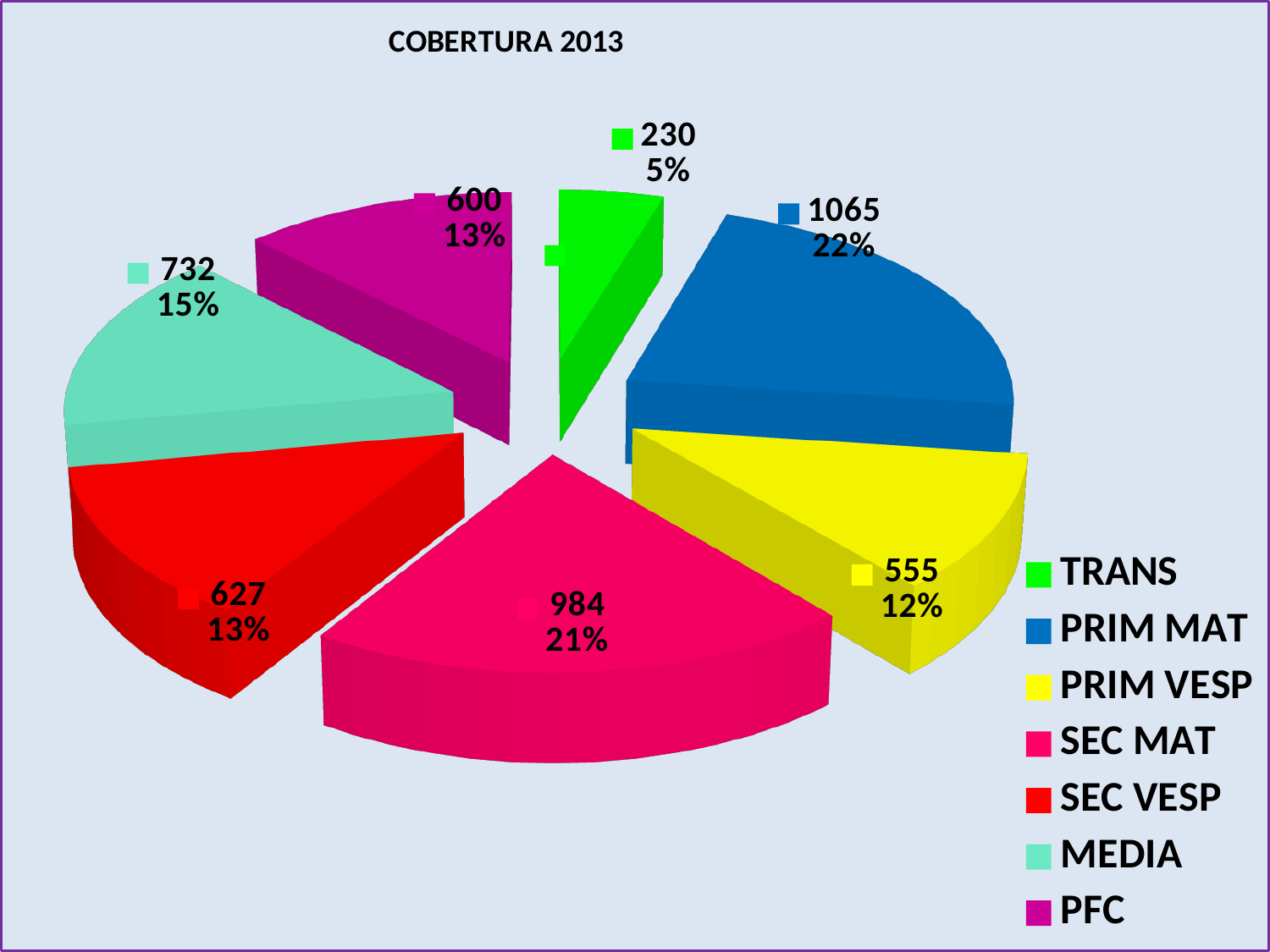
Which category has the highest value? PRIM MAT Which is larger, the value for MEDIA or the value for PFC? MEDIA What share of the pie does PRIM VESP represent? 12% What share of the pie does SEC MAT represent? 21% What is the value for SEC VESP? 627 What is the value for MEDIA? 732 What kind of chart is shown on the slide? Pie chart How many slices does the pie chart have? 7 What is the title of the chart? COBERTURA 2013 Which category has the lowest value? TRANS What is the difference between the values for PRIM MAT and SEC MAT? 81 What is the value for PRIM MAT? 1065